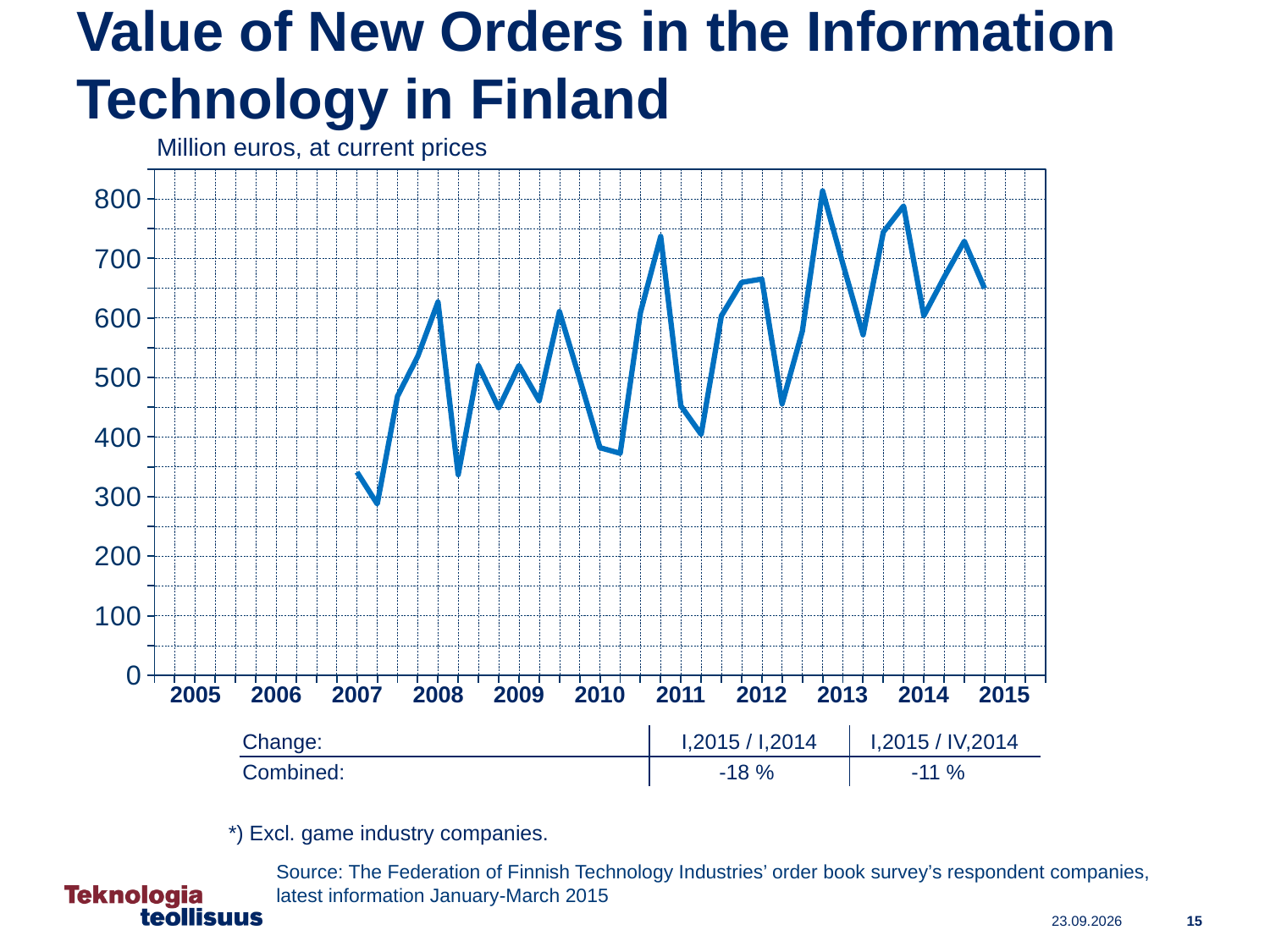
Is the peak reached during 2011 greater or less than 700? greater Is the last plotted value, in 2015, greater or less than 600? greater What kind of chart is shown on the slide? line chart How many year labels are shown on the x axis? 11 Overall, does the line rise or fall from its first point in 2007 to its last point in 2015? rise Is the first plotted value, at the start of 2007, greater or less than 400? less According to the table below the chart, what is the combined change for I,2015 / I,2014? -18 % What is the title of the chart? Value of New Orders in the Information Technology in Finland